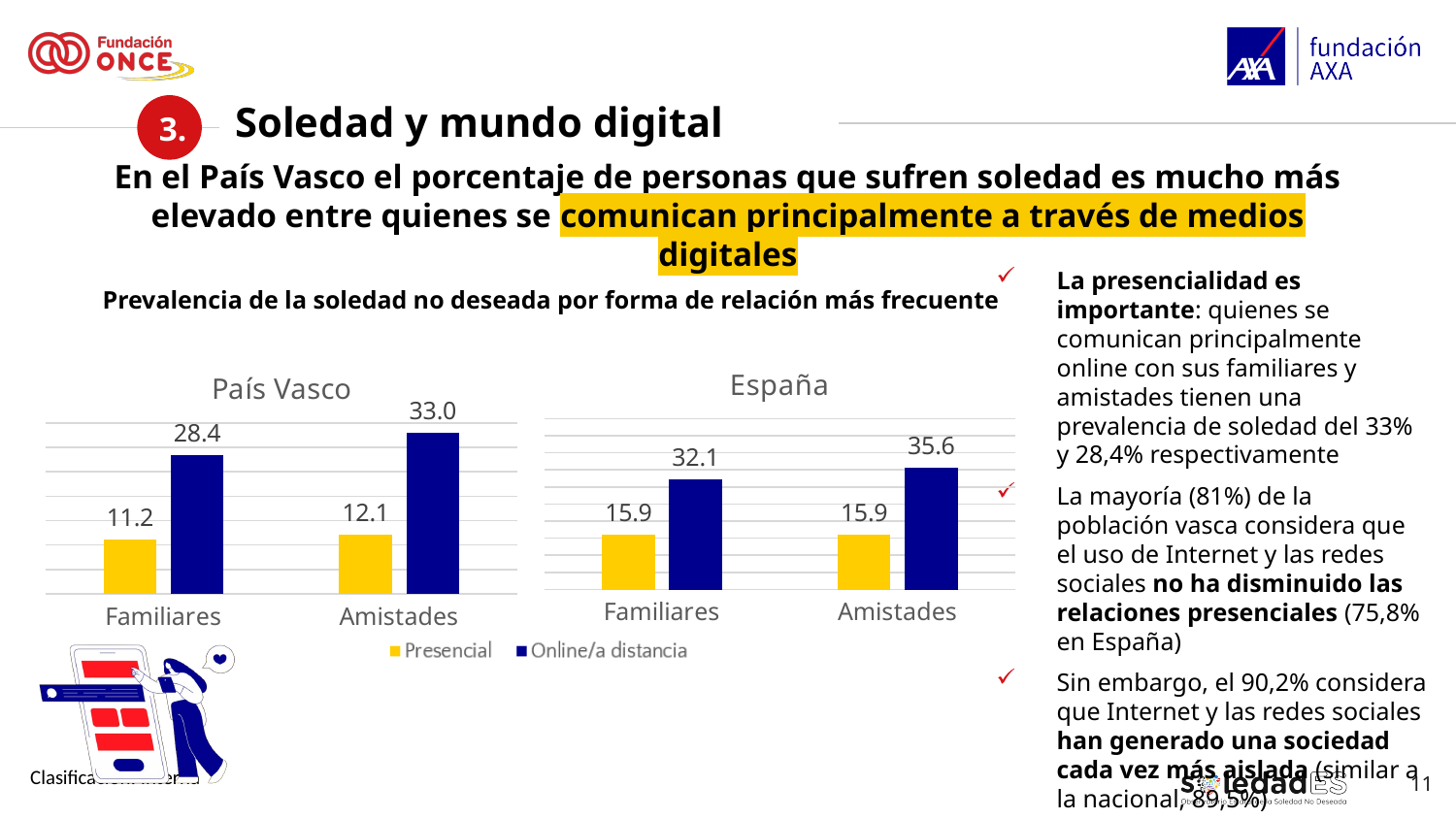
In the País Vasco chart, what is the difference between the Online/a distancia and Presencial values for Familiares? 17.2 How many series does the legend list for the charts? 2 In the España chart, what is the value for Online/a distancia for Familiares? 32.1 In the España chart, what is the difference between the Online/a distancia values for Amistades and Familiares? 3.5 What type of chart is the España chart? Bar chart In the País Vasco chart, which bar has the highest value? Online/a distancia, Amistades In the País Vasco chart, which bar has the lowest value? Presencial, Familiares In the País Vasco chart, what is the value for Online/a distancia for Amistades? 33.0 Which colour represents the Presencial series in the charts? Yellow In the País Vasco chart, what is the value for Presencial for Familiares? 11.2 In the España chart, which is larger: the Online/a distancia value for Amistades or for Familiares? Amistades In the España chart, what is the value for Presencial for Amistades? 15.9